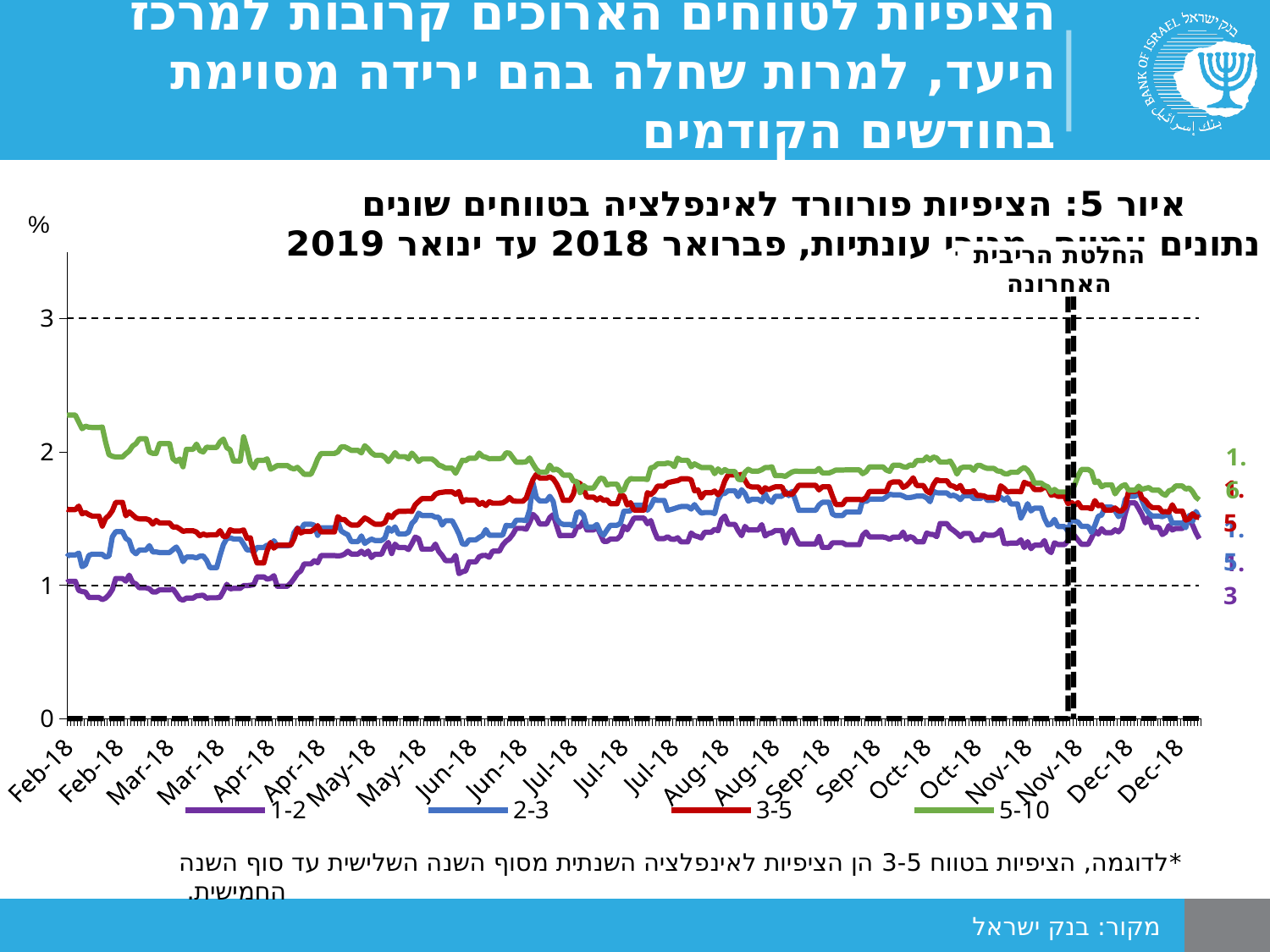
Is the value of the 5-10 series at the start of the period (Feb-18) greater or less than 2? greater Which is larger in Feb-18, the value of the 5-10 series or the value of the 1-2 series? 5-10 What is the highest value shown on the y axis? 3 Is the value of the 5-10 series at the end of the period (Dec-18) greater or less than 2? less Does the 1-2 series rise or fall overall from Feb-18 to Dec-18? rise Which series has the highest values across the whole period shown? 5-10 What are the four series listed in the legend? 1-2, 2-3, 3-5, 5-10 How many series does the legend list? 4 Which series has the lowest values at the start of the period (Feb-18)? 1-2 Is the value of the 3-5 series at the start of the period (Feb-18) greater or less than 2? less Does the 5-10 series rise or fall overall from Feb-18 to Dec-18? fall What kind of chart is shown on the slide? line chart